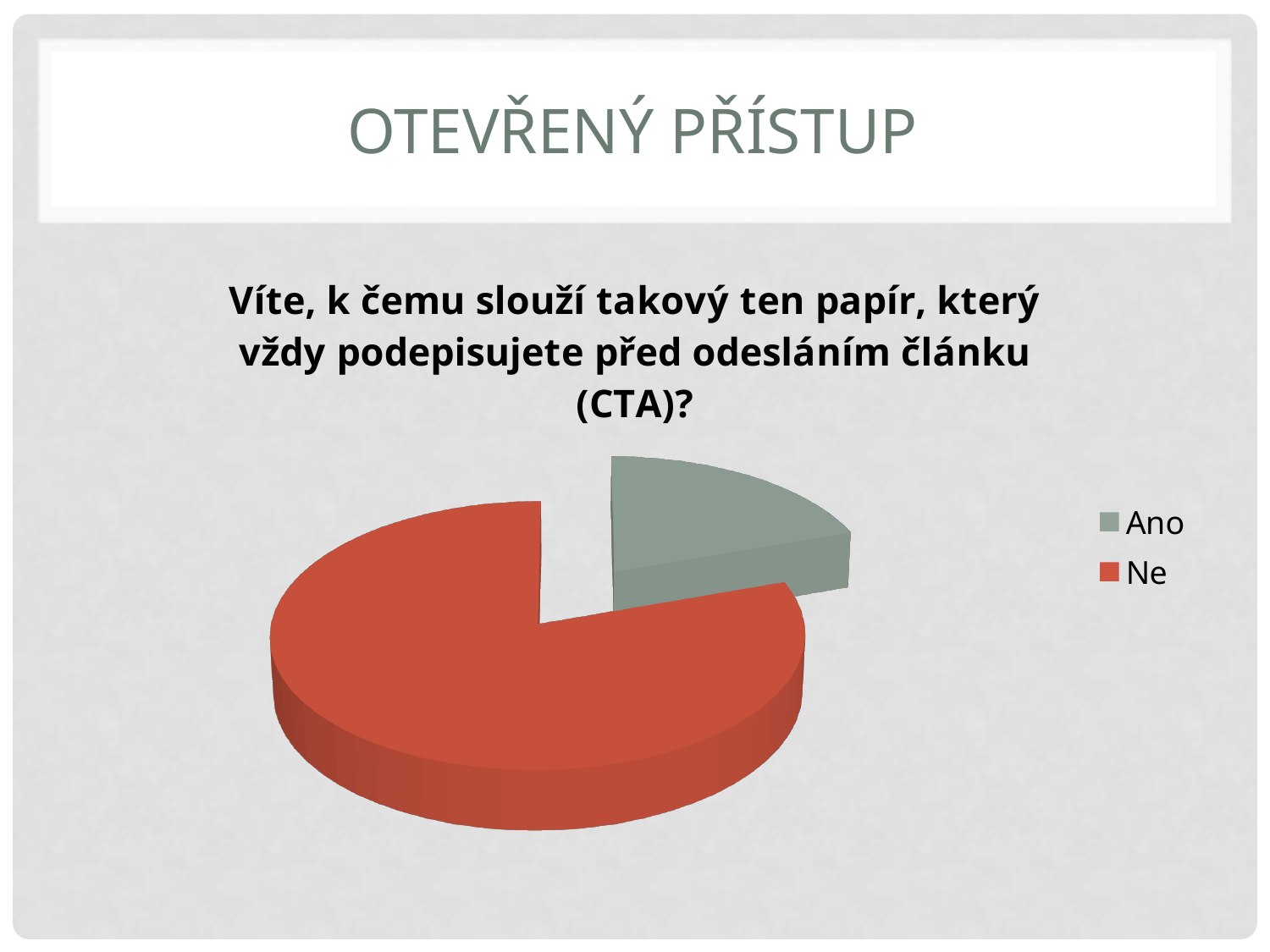
How many slices does the pie chart have? 2 What colour is the Ne slice in the pie chart? red Which slice is larger in the pie chart, Ano or Ne? Ne Which category has the largest slice in the pie chart? Ne What kind of chart is shown on the slide? pie chart Which category has the smallest slice in the pie chart? Ano What is the title of the pie chart? Víte, k čemu slouží takový ten papír, který vždy podepisujete před odesláním článku (CTA)? How many entries does the legend of the pie chart list? 2